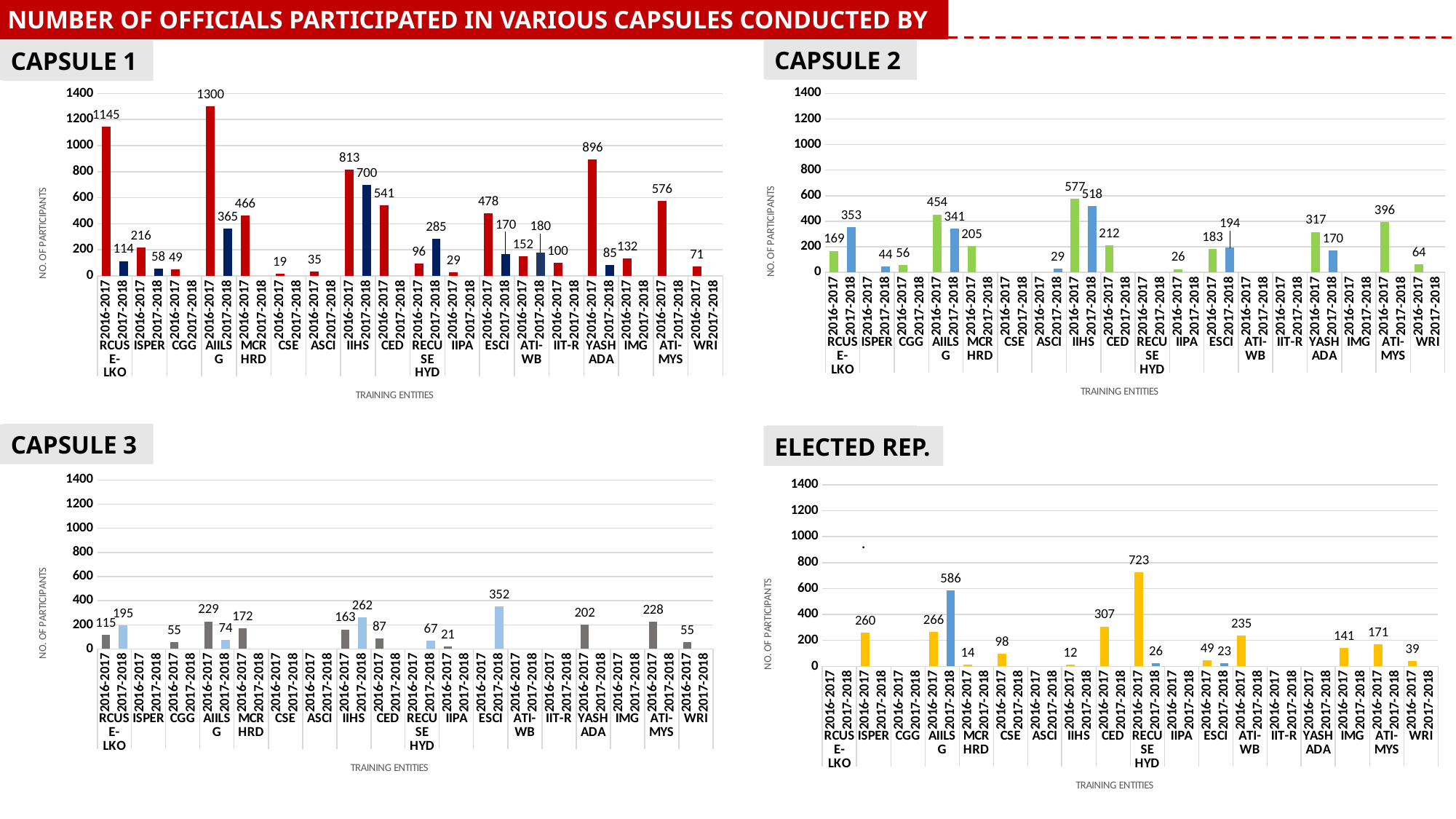
In the Capsule 2 chart, what is the value for IIHS in 2016-2017? 577 In the Capsule 2 chart, what is the value for ATI-MYS in 2016-2017? 396 In the Capsule 3 chart, which training entity has the highest value? ESCI In the Capsule 3 chart, what is the value for YASHADA in 2016-2017? 202 In the Elected Rep. chart, what is the difference between the AIILSG values for 2017-2018 and 2016-2017? 320 What is the y-axis label on the Capsule 3 chart? NO. OF PARTICIPANTS In the Capsule 1 chart, what is the difference between the IIHS values for 2016-2017 and 2017-2018? 113 In the Capsule 1 chart, which training entity has the highest value? AIILSG In the Capsule 1 chart, what is the value for AIILSG in 2016-2017? 1300 In the Elected Rep. chart, what is the value for RECUSE HYD in 2016-2017? 723 In the Capsule 2 chart, which is larger, the RCUSE-LKO value for 2016-2017 or for 2017-2018? 2017-2018 What kind of chart is the Capsule 1 chart? Bar chart